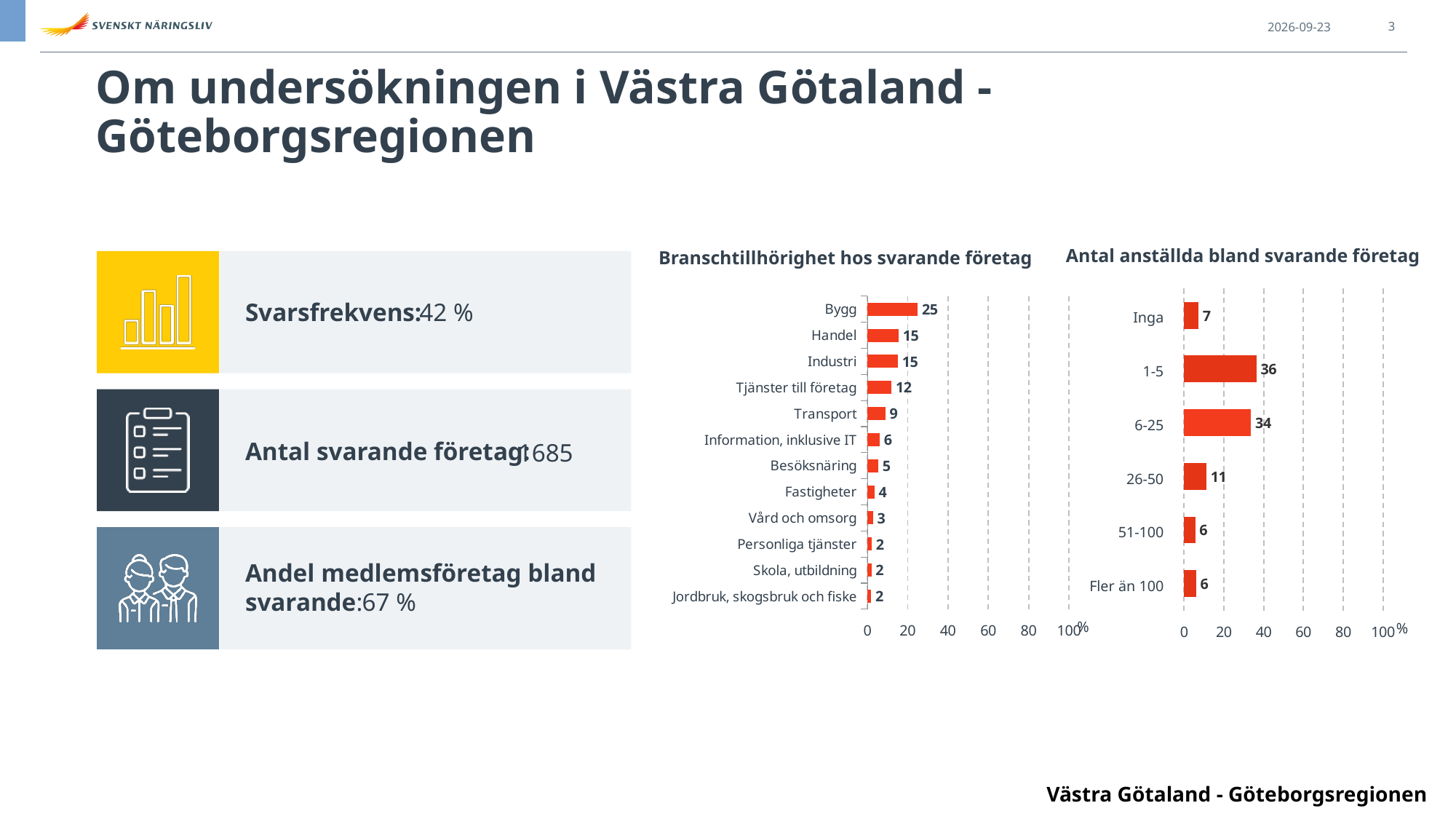
In the 'Branschtillhörighet hos svarande företag' chart, what is the value for Bygg? 25 In the 'Branschtillhörighet hos svarande företag' chart, how many categories are shown? 12 In the 'Branschtillhörighet hos svarande företag' chart, which category has the highest value? Bygg What kind of chart is the 'Antal anställda bland svarande företag' chart? Bar chart In the 'Antal anställda bland svarande företag' chart, what is the value for 26-50? 11 In the 'Antal anställda bland svarande företag' chart, which category has the highest value? 1-5 In the 'Antal anställda bland svarande företag' chart, what is the difference between 1-5 and 6-25? 2 In the 'Branschtillhörighet hos svarande företag' chart, what is the value for Transport? 9 In the 'Antal anställda bland svarande företag' chart, how many categories are shown? 6 In the 'Branschtillhörighet hos svarande företag' chart, what is the difference between Bygg and Handel? 10 In the 'Branschtillhörighet hos svarande företag' chart, which is larger, Tjänster till företag or Besöksnäring? Tjänster till företag In the 'Antal anställda bland svarande företag' chart, what is the value for 1-5? 36